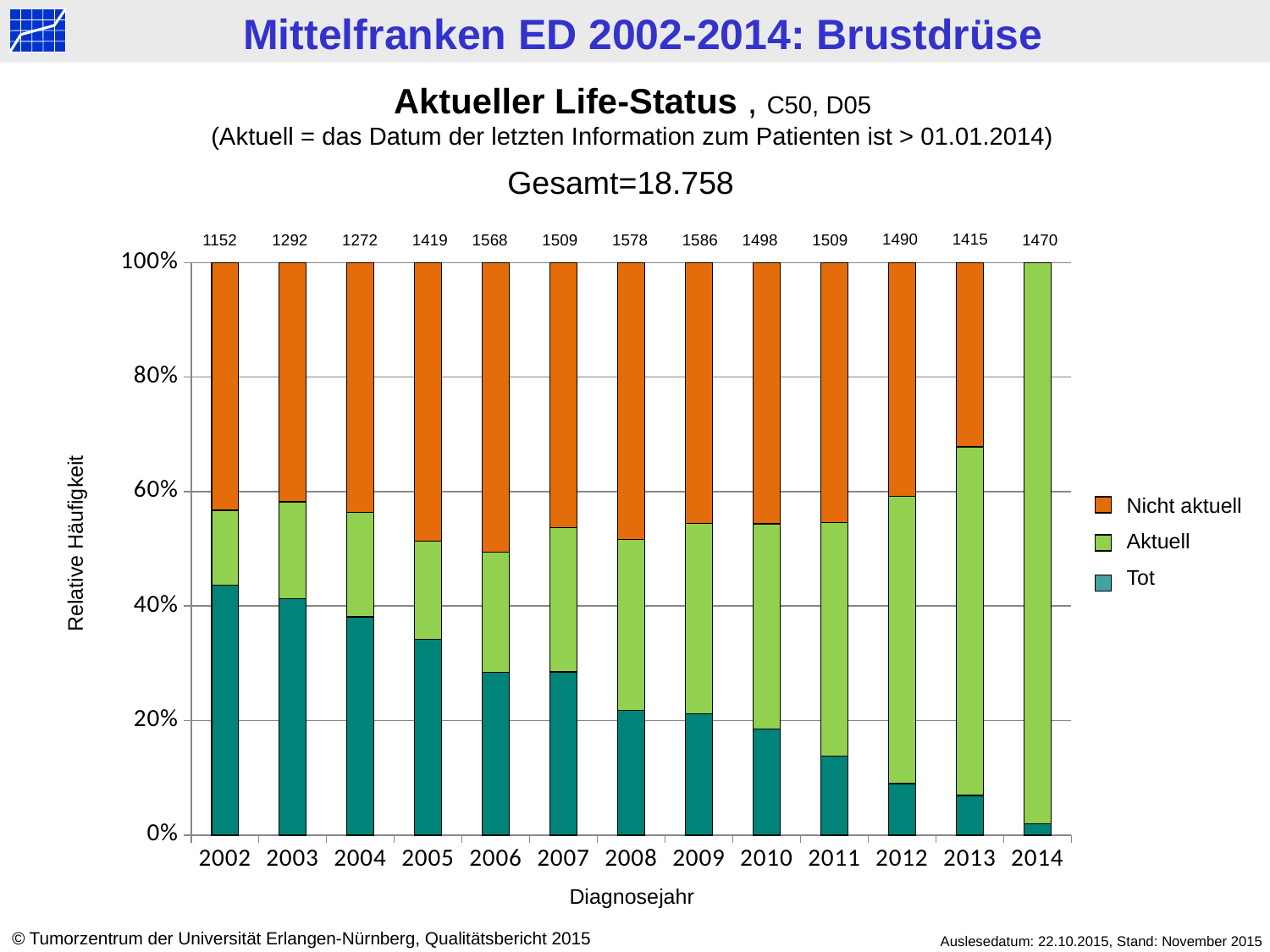
Does the share of 'Tot' rise or fall from 2002 to 2014? fall How many series does the legend list? 3 How many diagnosis years are shown on the x axis? 13 What is the difference between the numbers printed above the bars for 2014 and 2013? 55 What kind of chart is shown on the slide? bar chart Is the share of 'Tot' in 2011 greater or less than 20%? less Which year has the lowest number printed above its bar? 2002 What number is printed above the bar for 2002? 1152 What number is printed above the bar for 2009? 1586 Is the share of 'Tot' in 2002 greater or less than 40%? greater What is the title of the x axis? Diagnosejahr Which year has the highest number printed above its bar? 2009